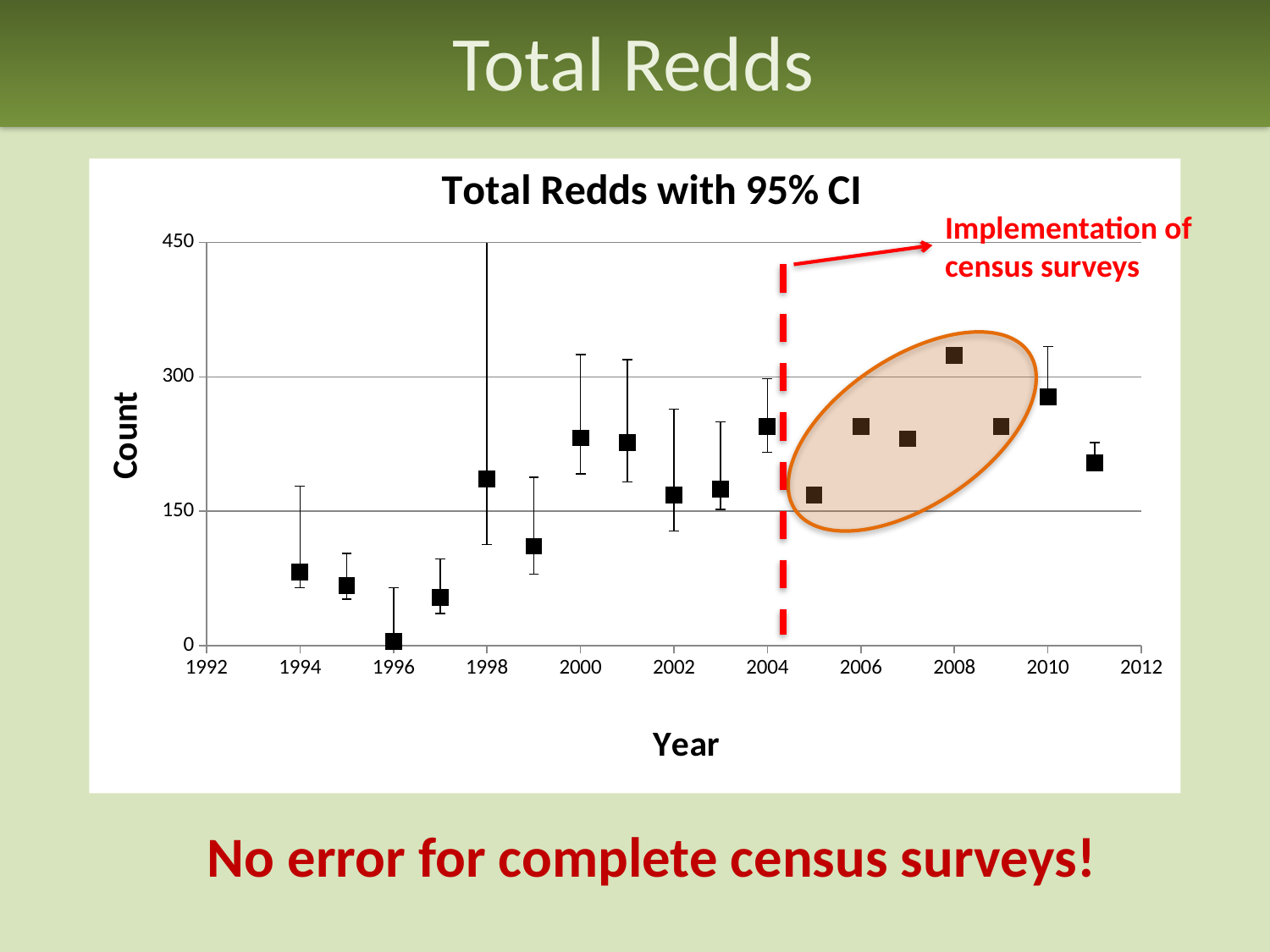
Which year has the highest count? 2008 What kind of chart is shown on the slide? Scatter plot with error bars Is the count for 2000 greater or less than 150? greater Is the count for 2010 greater or less than 300? less Overall, do the counts rise or fall from 1994 to 2011? rise Is the count for 1996 greater or less than 150? less What is the title of the chart? Total Redds with 95% CI Which year has a higher count, 1994 or 1998? 1998 How many data points are plotted in the chart? 18 What is the label of the y axis? Count Which year has the lowest count? 1996